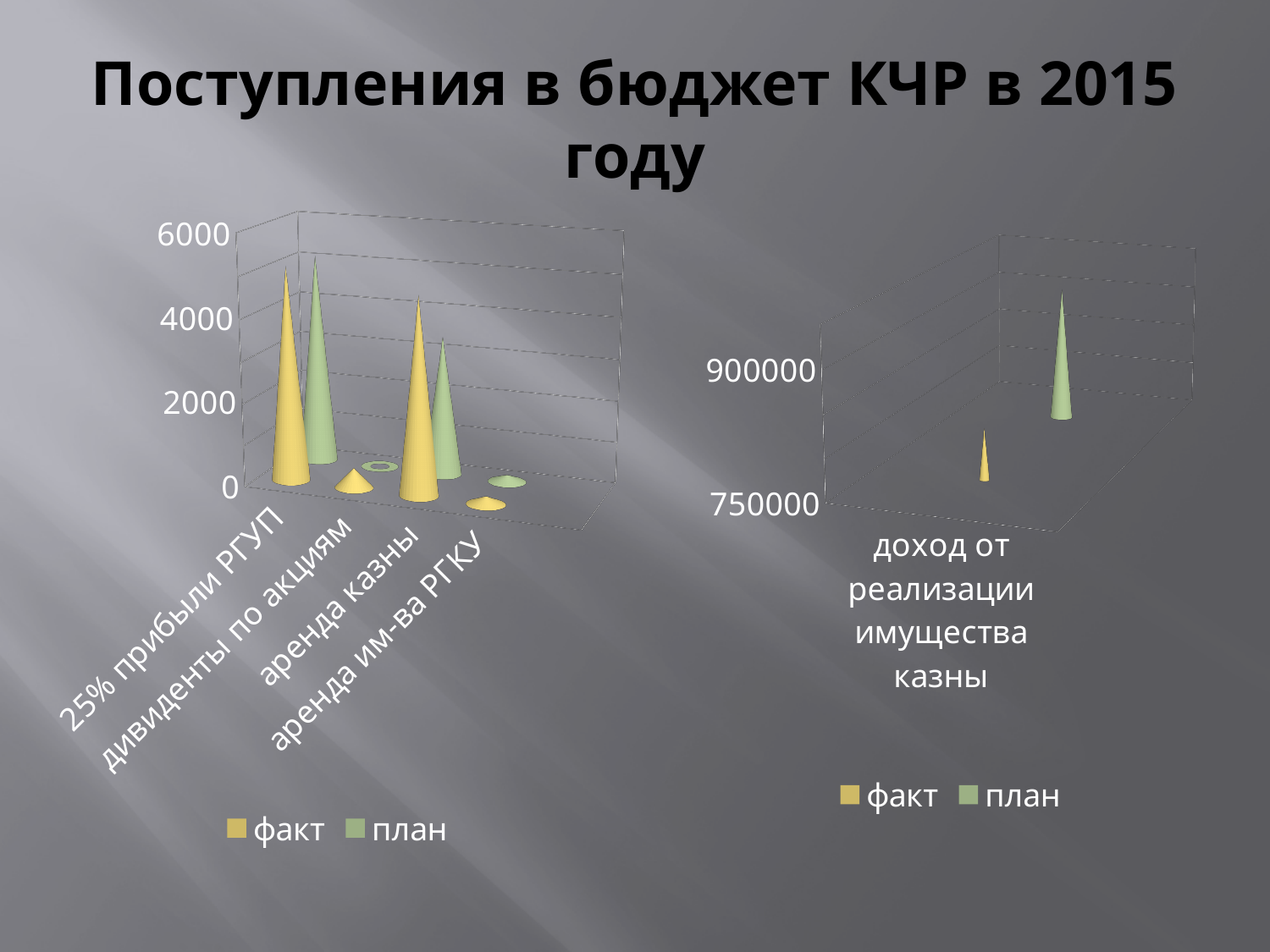
In the right chart, which is larger for доход от реализации имущества казны, факт or план? план In the right chart, how many categories are shown on the x axis? 1 In the left chart, how many series does the legend list? 2 In the left chart, is the факт value for дивиденты по акциям greater or less than 2000? less In the left chart, is the факт value for 25% прибыли РГУП greater or less than 4000? greater In the left chart, how many categories are shown on the x axis? 4 In the right chart, how many series does the legend list? 2 In the right chart, is the факт value for доход от реализации имущества казны greater or less than 900000? less What is the title of the slide? Поступления в бюджет КЧР в 2015 году In the left chart, what are the series named in the legend? факт, план